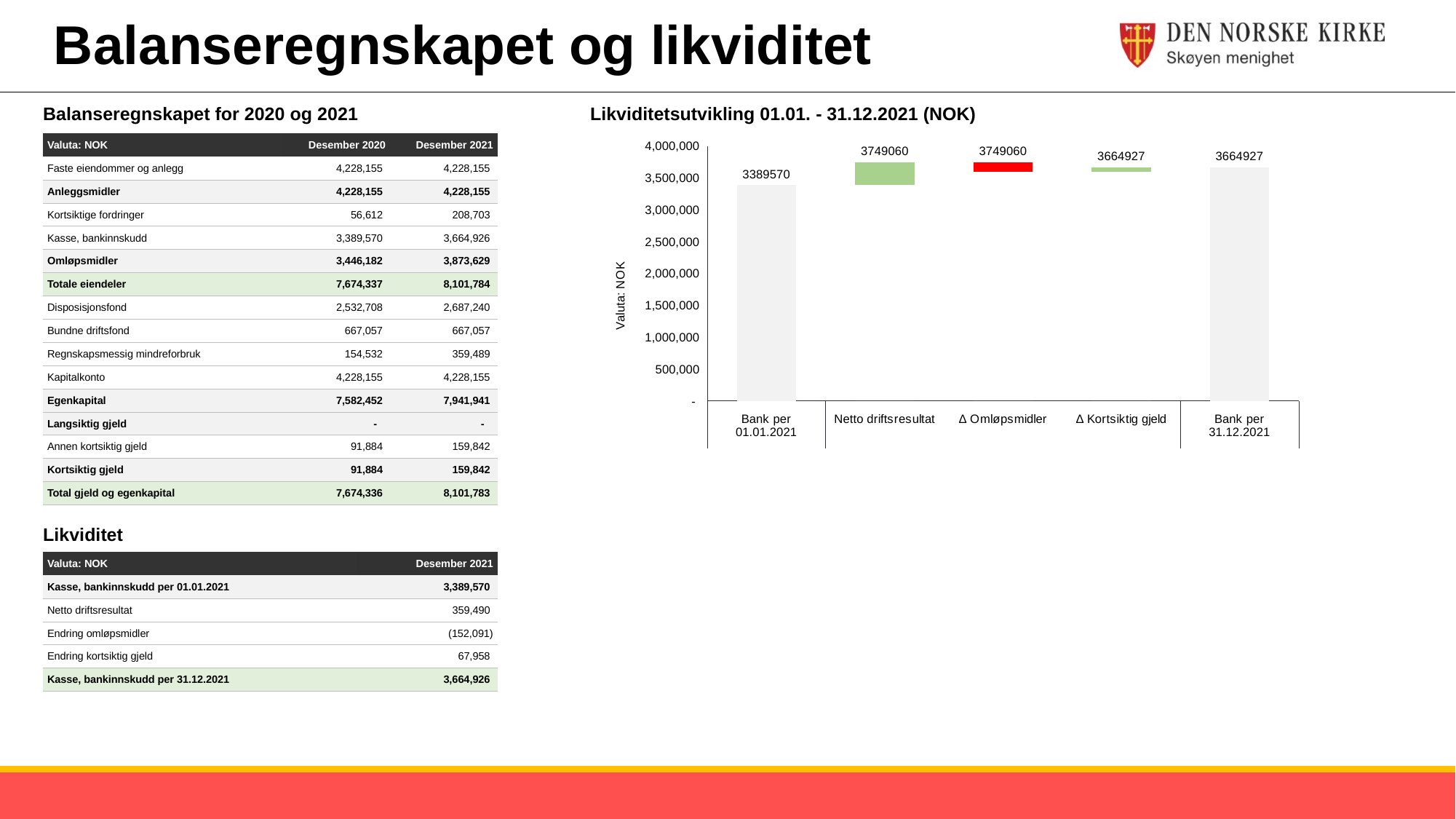
In the Likviditetsutvikling chart, what is the difference between the Bank per 31.12.2021 label and the Bank per 01.01.2021 label? 275357 In the Likviditetsutvikling chart, which is larger: the value for Bank per 31.12.2021 or the value for Bank per 01.01.2021? Bank per 31.12.2021 In the Likviditetsutvikling chart, is the value for Bank per 01.01.2021 greater or less than 3,500,000? less What data label is printed above the Netto driftsresultat bar in the Likviditetsutvikling chart? 3749060 What kind of chart is the Likviditetsutvikling 01.01. - 31.12.2021 chart? bar chart How many categories are shown on the x axis of the Likviditetsutvikling chart? 5 What is the data label shown for Bank per 31.12.2021 in the Likviditetsutvikling chart? 3664927 In the Likviditetsutvikling chart, is the value for Bank per 31.12.2021 greater or less than 3,500,000? greater What data label is printed above the Δ Kortsiktig gjeld bar in the Likviditetsutvikling chart? 3664927 What is the data label shown for Bank per 01.01.2021 in the Likviditetsutvikling chart? 3389570 What is the y-axis title of the Likviditetsutvikling chart? Valuta: NOK Which category has the lowest data label in the Likviditetsutvikling chart? Bank per 01.01.2021